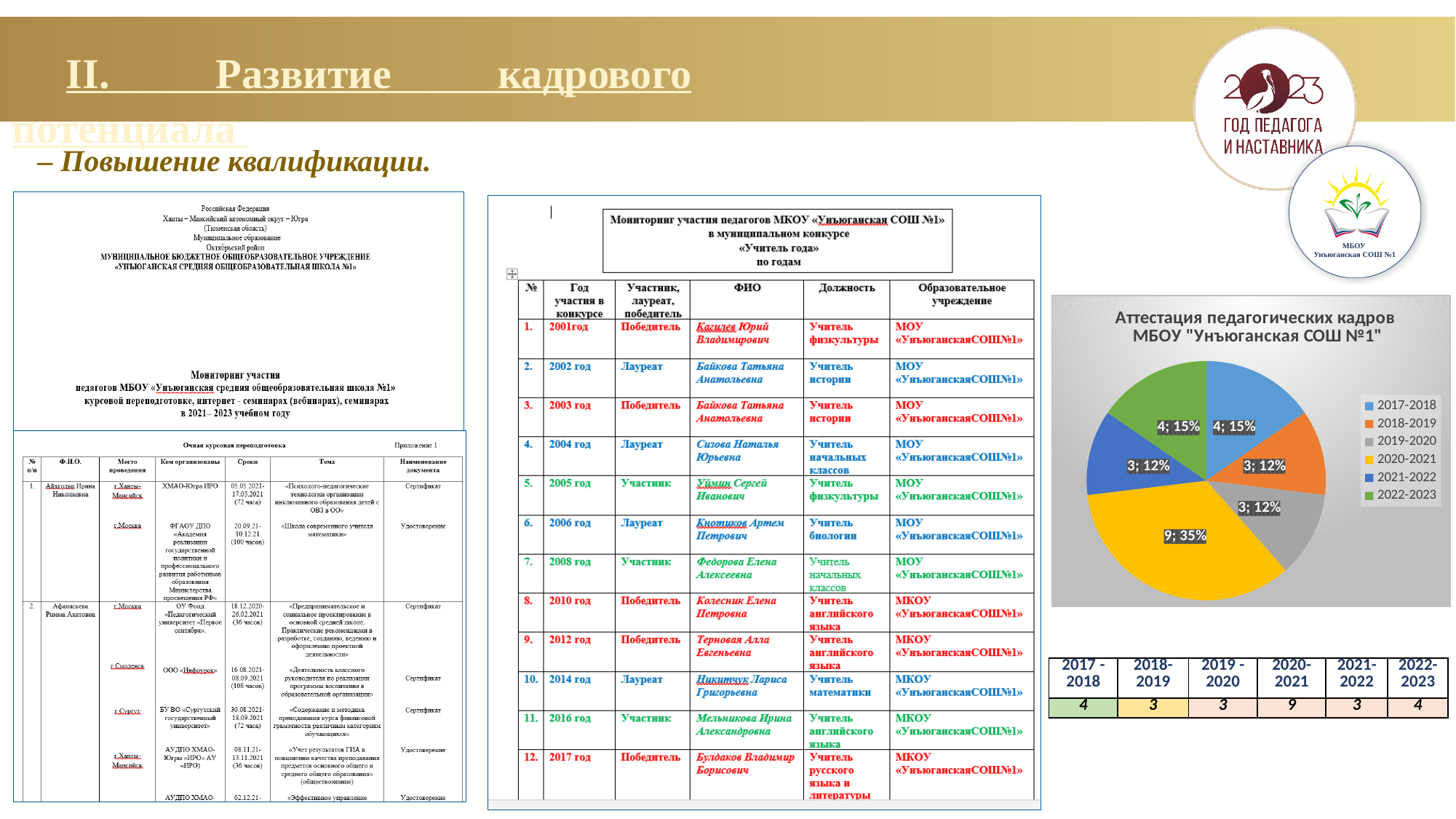
What is the difference between the count for 2020-2021 and the count for 2019-2020 in the pie chart? 6 What kind of chart is shown on the slide? pie chart How many series does the legend of the pie chart list? 6 What share of the pie does the 2020-2021 slice represent? 35% What is the data label for the 2020-2021 slice in the pie chart? 9; 35% What is the data label for the 2018-2019 slice in the pie chart? 3; 12% What is the title of the pie chart? Аттестация педагогических кадров МБОУ "Унъюганская СОШ №1" How many slices does the pie chart have? 6 What share of the pie does the 2022-2023 slice represent? 15% What is the data label for the 2017-2018 slice in the pie chart? 4; 15% Which year has the largest slice in the pie chart? 2020-2021 In the pie chart, which is larger: the value for 2020-2021 or the value for 2021-2022? 2020-2021